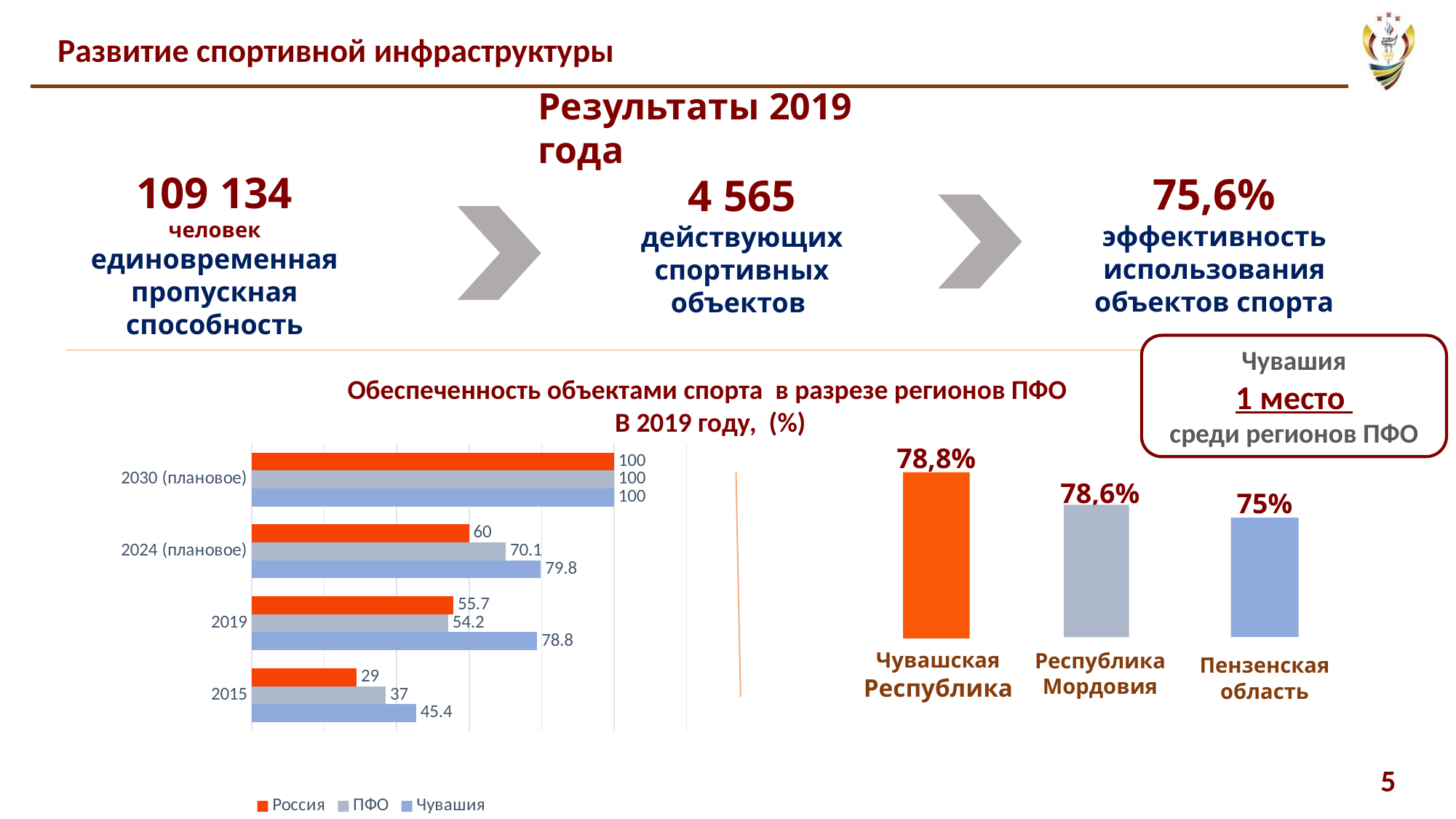
In the left chart, how many series does the legend list? 3 In the left chart, what is the value for Чувашия in 2019? 78.8 In the right chart, which region has the lowest value? Пензенская область What kind of chart is the left chart? bar chart In the right chart, what is the difference between Чувашская Республика and Пензенская область? 3,8% In the right chart, what is the value for Республика Мордовия? 78,6% In the left chart, how many year categories are shown on the vertical axis? 4 In the left chart, what is the value for Россия in 2015? 29 In the left chart, which series has the lowest value in 2015? Россия In the left chart, does the Чувашия value rise or fall from 2015 to 2030 (плановое)? rise In the left chart, what is the difference between the Чувашия and Россия values in 2019? 23.1 In the left chart, what is the value for ПФО in 2024 (плановое)? 70.1